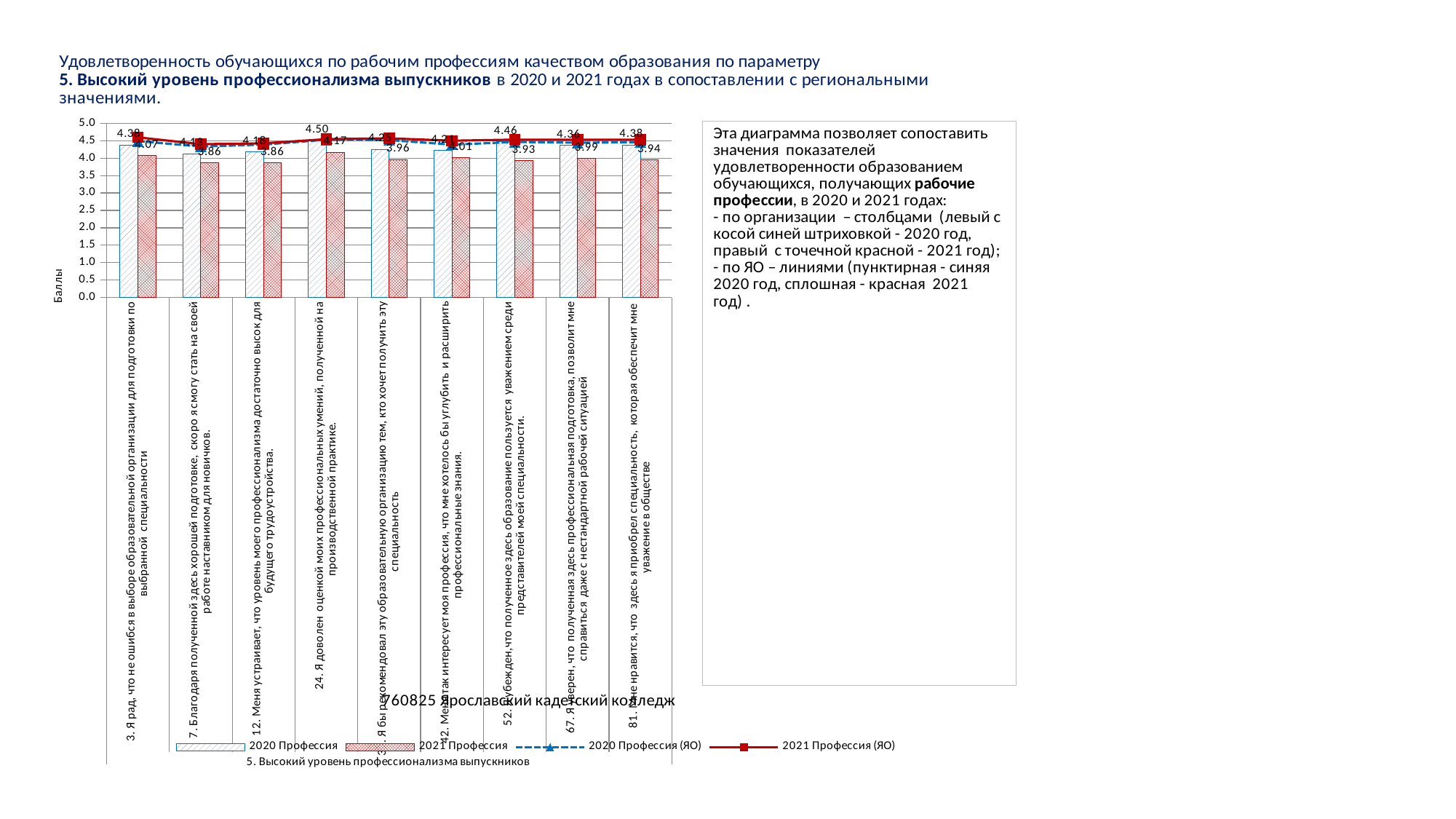
Which is larger: the 2021 Профессия value for category 24 or for category 52? Category 24 Is the 2021 Профессия value for category 7 greater or less than 4.0? less Which category has the highest 2021 Профессия value? 24. Я доволен оценкой моих профессиональных умений, полученной на производственной практике. Which category has the highest 2020 Профессия value? 24. Я доволен оценкой моих профессиональных умений, полученной на производственной практике. What is the 2021 Профессия value for category 52 (Убежден, что полученное здесь образование пользуется уважением...)? 3.93 What is the 2020 Профессия value for category 3 (Я рад, что не ошибся в выборе образовательной организации...)? 4.38 How many categories (questions) are shown on the x axis of the chart? 9 How many series does the chart legend list? 4 What is the 2021 Профессия value for category 81 (Мне нравится, что здесь я приобрел специальность...)? 3.94 What is the label of the vertical axis of the chart? Баллы What is the difference between the 2020 Профессия and 2021 Профессия values for category 24? 0.33 What is the 2021 Профессия value for category 24 (Я доволен оценкой моих профессиональных умений...)? 4.17